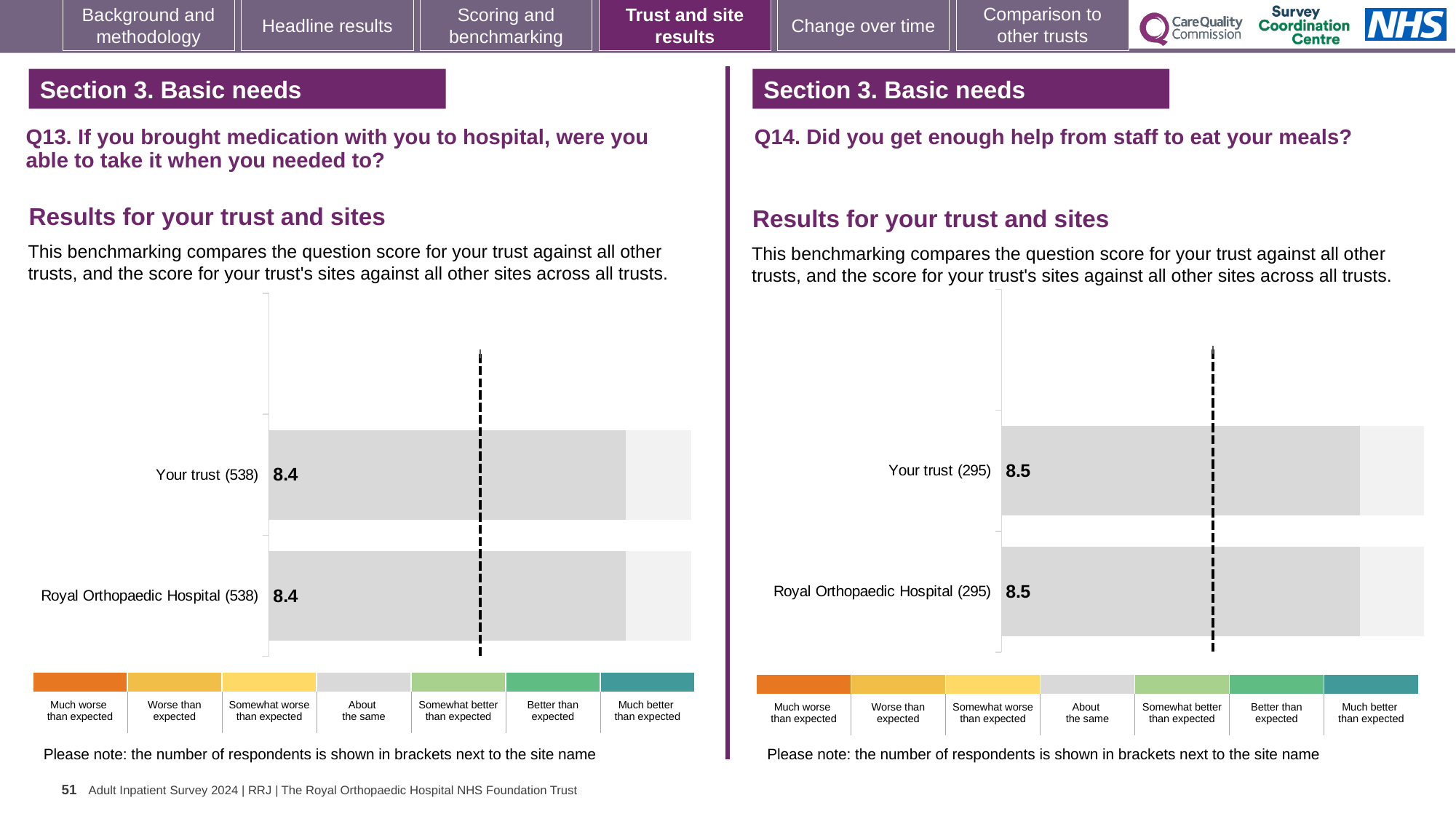
How many respondents are shown in brackets for Your trust in the Q14 chart on the right? 295 In the Q14 chart on the right, what is the score for Royal Orthopaedic Hospital (295)? 8.5 In the Q14 chart on the right, what is the difference between the score for Your trust and the score for Royal Orthopaedic Hospital? 0 How many bars are plotted in the Q13 chart on the left? 2 In the Q14 chart on the right, what is the score for Your trust (295)? 8.5 How many bars are plotted in the Q14 chart on the right? 2 In the Q13 chart on the left, what is the score for Your trust (538)? 8.4 In the Q13 chart on the left, what is the score for Royal Orthopaedic Hospital (538)? 8.4 Is the score for Your trust in the Q14 chart on the right greater or less than the score for Your trust in the Q13 chart on the left? greater In the Q13 chart on the left, what is the difference between the score for Your trust and the score for Royal Orthopaedic Hospital? 0 What kind of chart is used for the Q13 results on the left? Bar chart How many categories does the colour key below the Q13 chart on the left list? 7